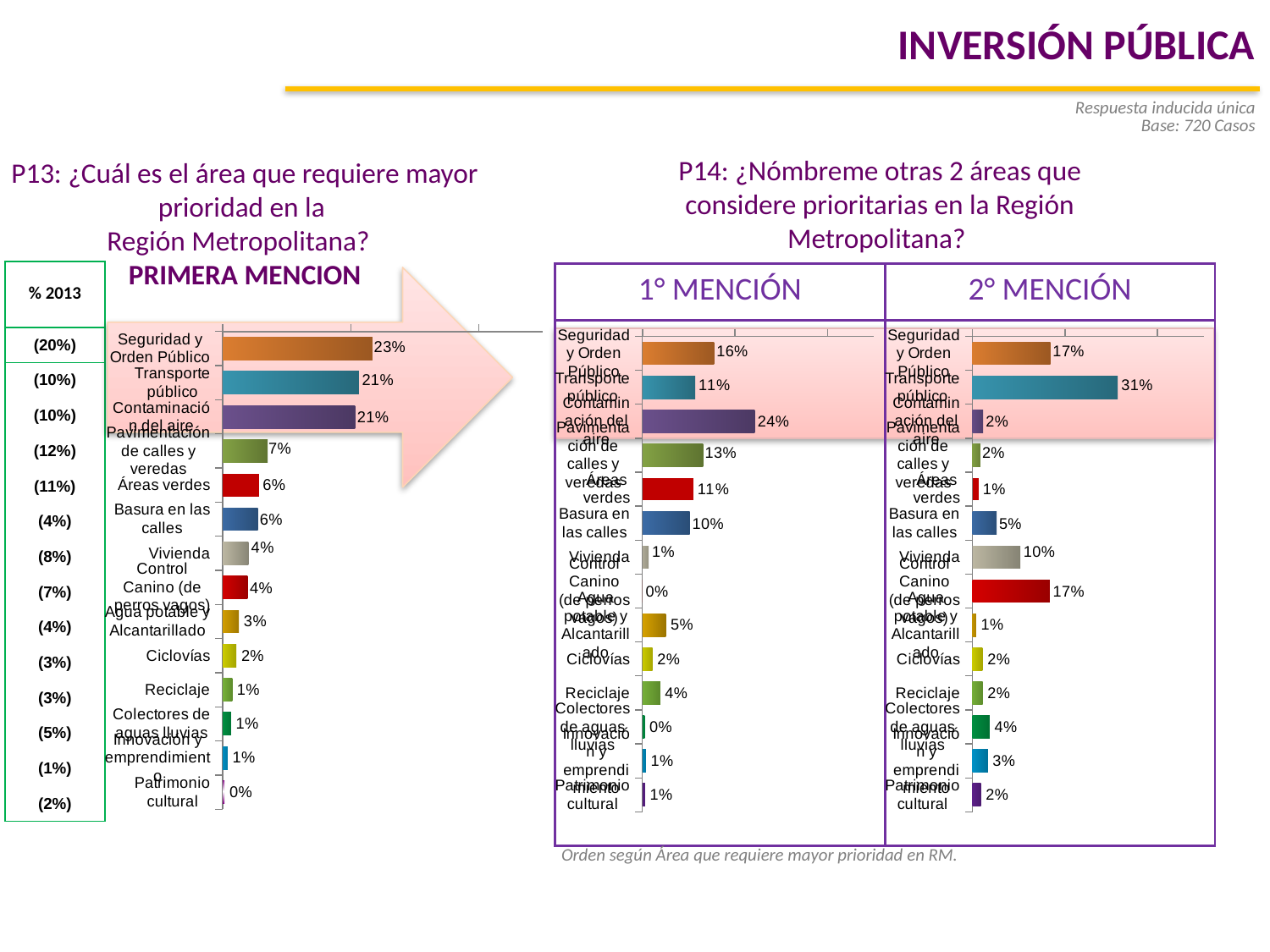
What type of chart is the 2° MENCIÓN chart? Bar chart In the PRIMERA MENCION chart, what is the value for Pavimentación de calles y veredas? 7% In the 2° MENCIÓN chart, what is the value for Transporte público? 31% In the 1° MENCIÓN chart, what is the value for Reciclaje? 4% In the 2° MENCIÓN chart, which is larger, Vivienda or Basura en las calles? Vivienda In the 2° MENCIÓN chart, which category has the highest value? Transporte público How many categories are shown in the PRIMERA MENCION chart? 14 In the PRIMERA MENCION chart, which category has the highest value? Seguridad y Orden Público In the 1° MENCIÓN chart, what is the value for Pavimentación de calles y veredas? 13% In the PRIMERA MENCION chart, what is the difference between Seguridad y Orden Público and Transporte público? 2% In the PRIMERA MENCION chart, what is the value for Seguridad y Orden Público? 23% In the 1° MENCIÓN chart, which category has the highest value? Contaminación del aire